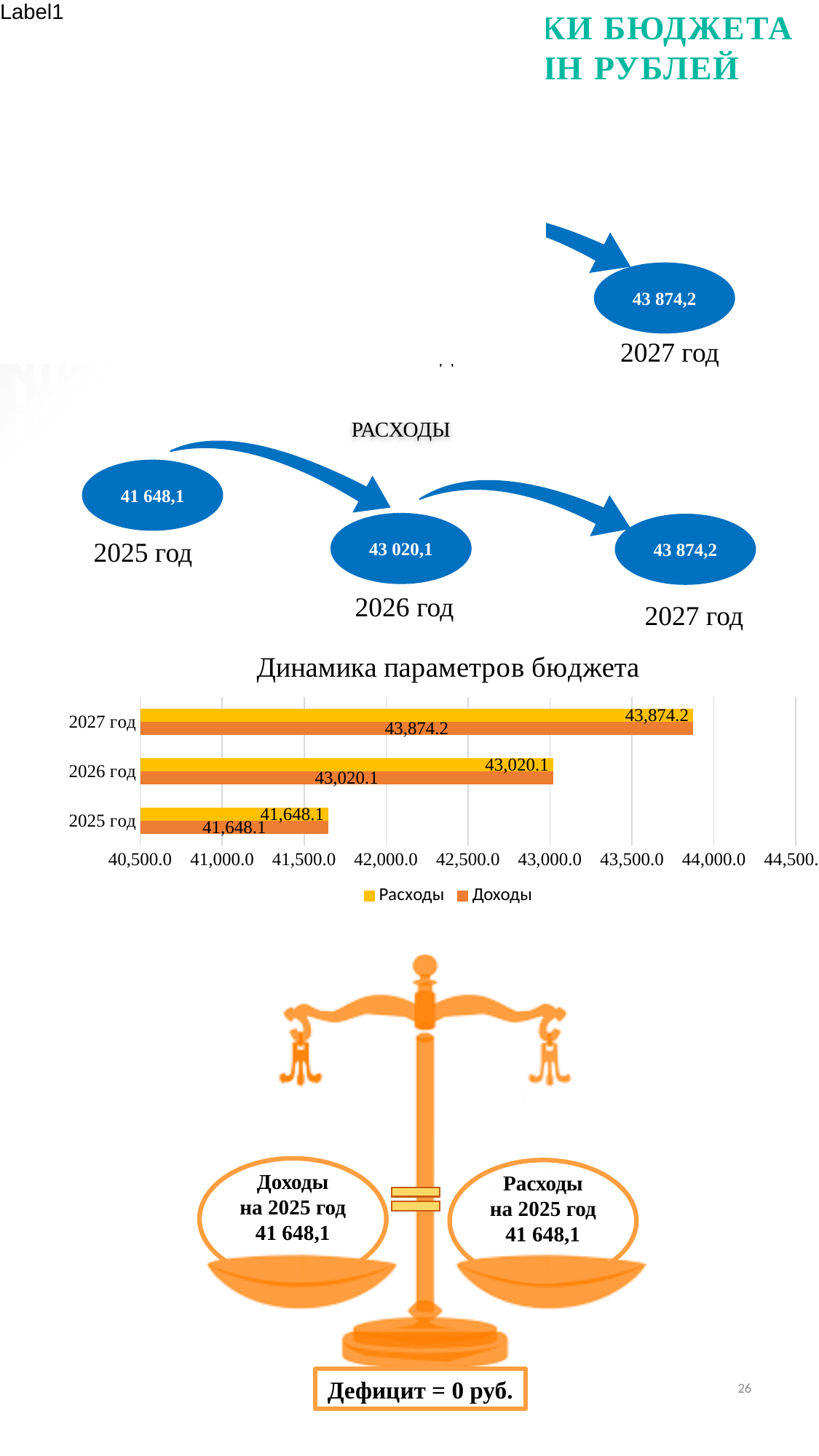
What type of chart is 'Динамика параметров бюджета'? Bar chart In the chart 'Динамика параметров бюджета', what is the value of Расходы for 2027 год? 43,874.2 In the chart 'Динамика параметров бюджета', is the value of Расходы for 2026 год greater or less than 42,500.0? greater In the chart 'Динамика параметров бюджета', what is the value of Доходы for 2025 год? 41,648.1 In the chart 'Динамика параметров бюджета', which year has the highest value for Расходы? 2027 год How many years (categories) are shown in the chart 'Динамика параметров бюджета'? 3 In the chart 'Динамика параметров бюджета', what is the value of Доходы for 2026 год? 43,020.1 How many series does the legend of the chart 'Динамика параметров бюджета' list? 2 In the chart 'Динамика параметров бюджета', what is the difference between Расходы for 2027 год and Расходы for 2025 год? 2,226.1 In the chart 'Динамика параметров бюджета', which year has the lowest value for Доходы? 2025 год In the chart 'Динамика параметров бюджета', which colour represents the Доходы series? Orange In the chart 'Динамика параметров бюджета', which is larger: Доходы for 2026 год or Доходы for 2027 год? 2027 год